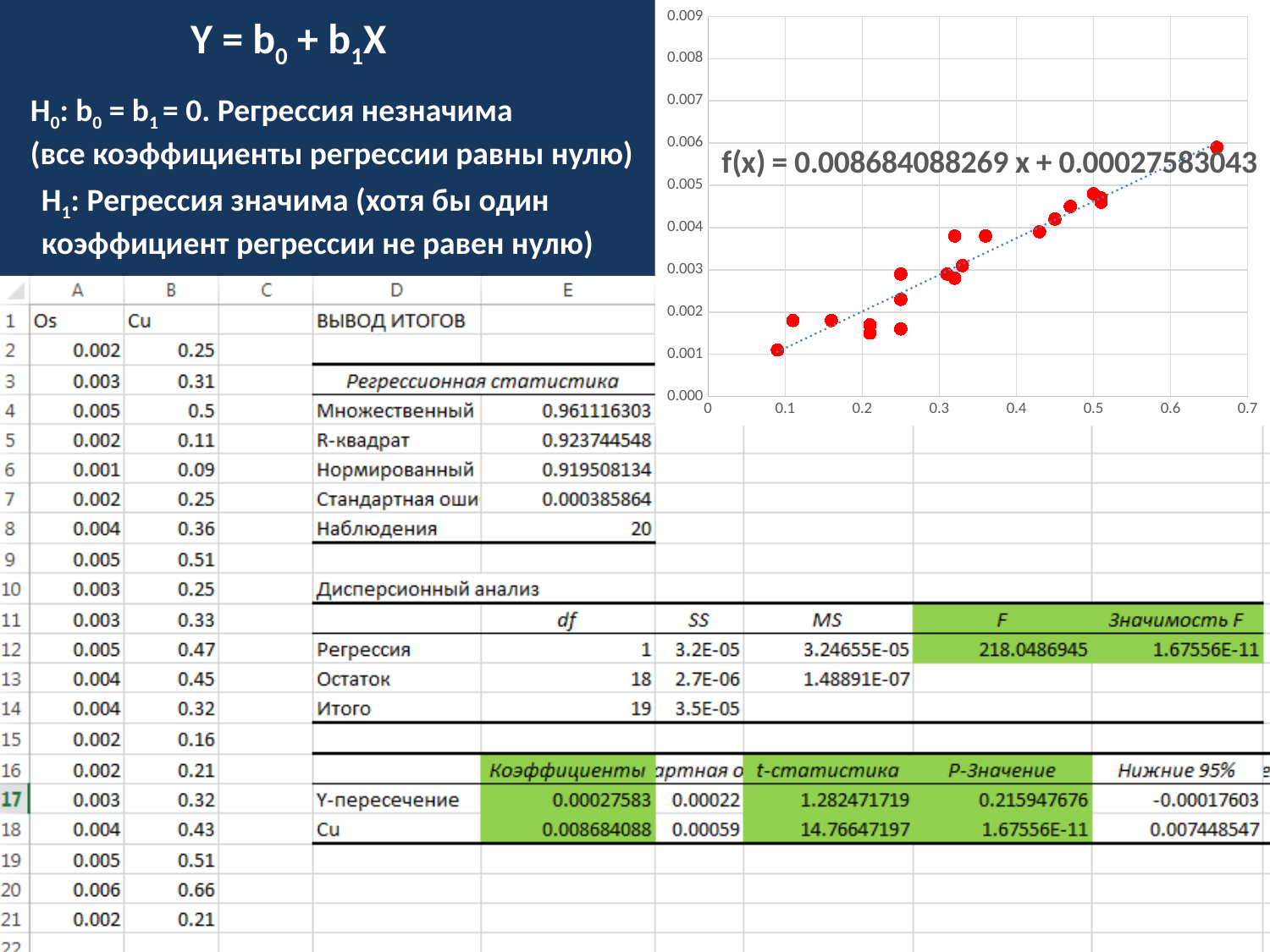
What is the intercept shown in the trendline equation on the scatter chart? 0.00027583043 What kind of chart is shown on the right side of the slide? Scatter chart What colour are the data point markers in the scatter chart? Red In the scatter chart, do the y values generally rise or fall as x increases? Rise In the scatter chart, does the point with the largest x value also have the largest y value? Yes What is the slope coefficient shown in the trendline equation on the scatter chart? 0.008684088269 How many observations are plotted in the scatter chart, according to the 'Наблюдения' row on the slide? 20 In the scatter chart, is the y value of the leftmost point greater or less than 0.002? less What trendline equation is displayed on the scatter chart? f(x) = 0.008684088269 x + 0.00027583043 In the scatter chart, is the y value of the rightmost point greater or less than 0.007? less In the scatter chart, which point has the higher y value: the leftmost point or the rightmost point? The rightmost point In the scatter chart, is the y value of the rightmost point greater or less than 0.005? greater